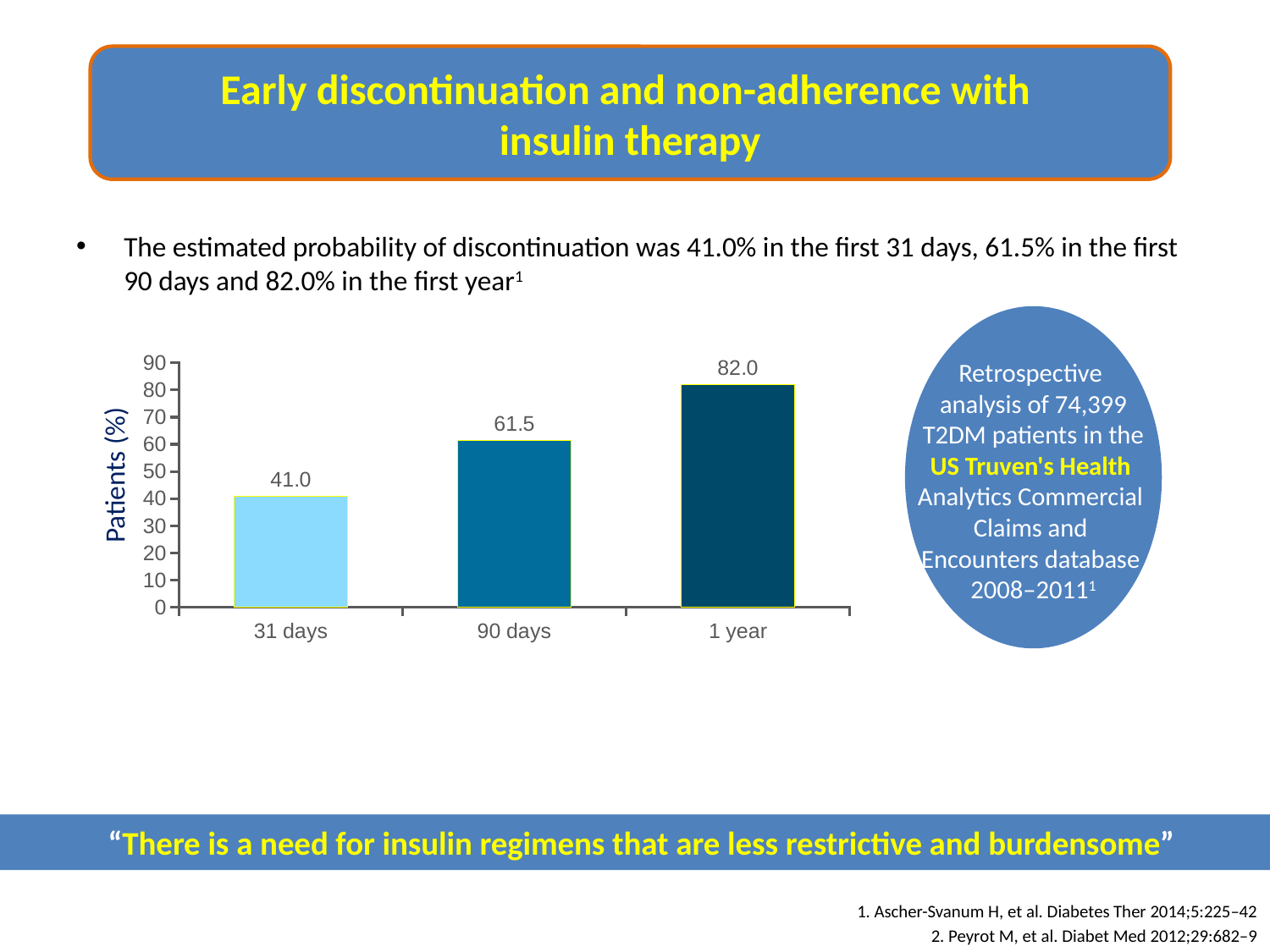
Which category has the lowest value? 31 days What is the value for 1 year? 82.0 How many categories are shown on the x axis? 3 Which is larger, the value for 90 days or the value for 1 year? 1 year What is the value for 90 days? 61.5 What is the difference between the values for 1 year and 31 days? 41.0 Which category has the highest value? 1 year Is the value for 90 days greater or less than 50? greater What is the value for 31 days? 41.0 What kind of chart is shown on the slide? bar chart What is the difference between the values for 90 days and 31 days? 20.5 Do the values rise or fall from 31 days to 1 year? rise